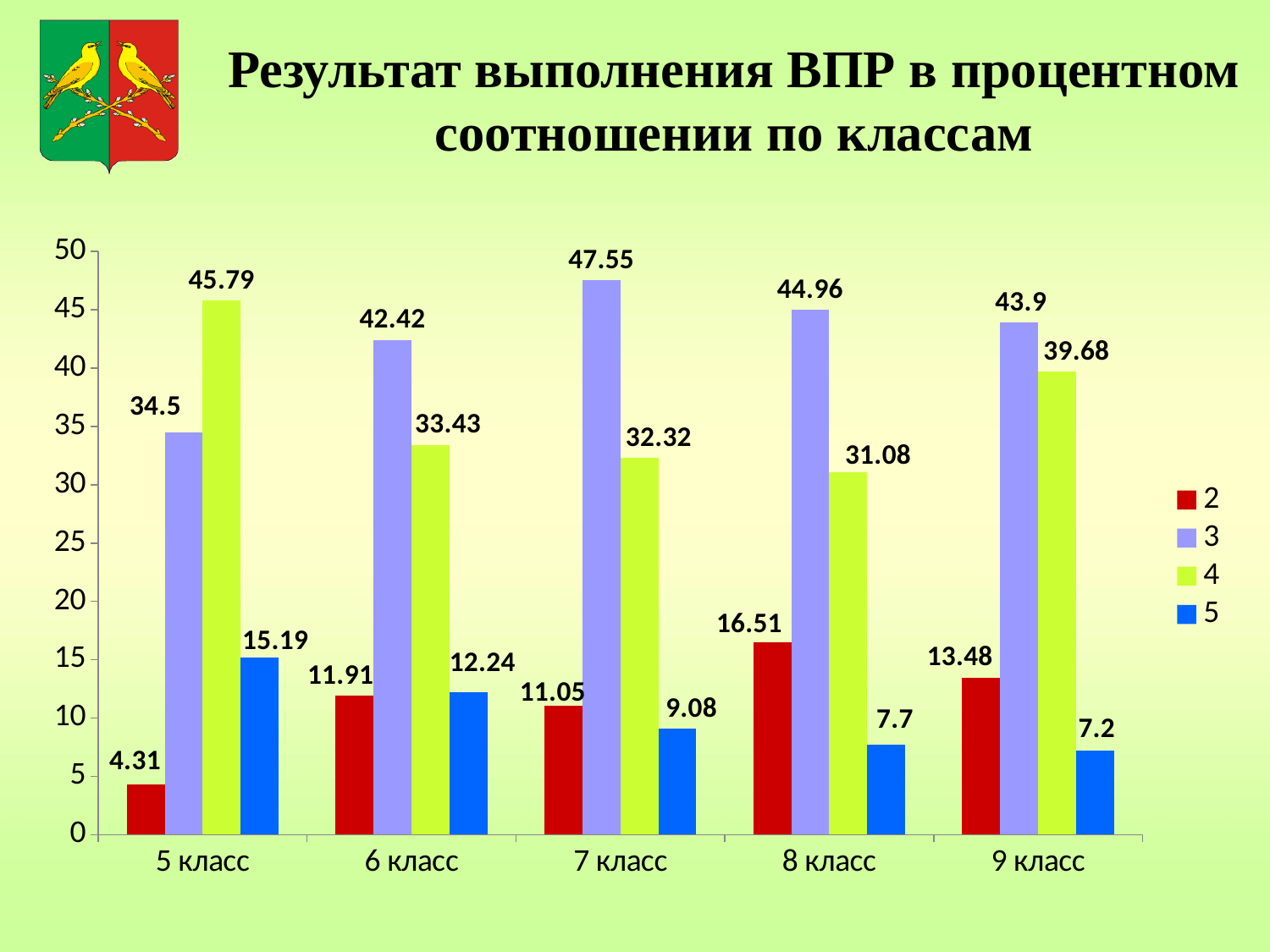
Do the values for series 5 rise or fall from 5 класс to 9 класс? fall Which is larger in 6 класс: the value for series 3 or series 4? series 3 How many classes are shown on the x axis? 5 Which class has the lowest value for series 2? 5 класс Is the value for series 5 in 5 класс greater or less than 10? greater What is the value for series 4 in 5 класс? 45.79 What is the value for series 5 in 9 класс? 7.2 Which class has the highest value for series 3? 7 класс What kind of chart is shown on the slide? bar chart What is the value for series 2 in 8 класс? 16.51 What is the difference between the series 3 and series 4 values in 9 класс? 4.22 How many series does the legend list? 4